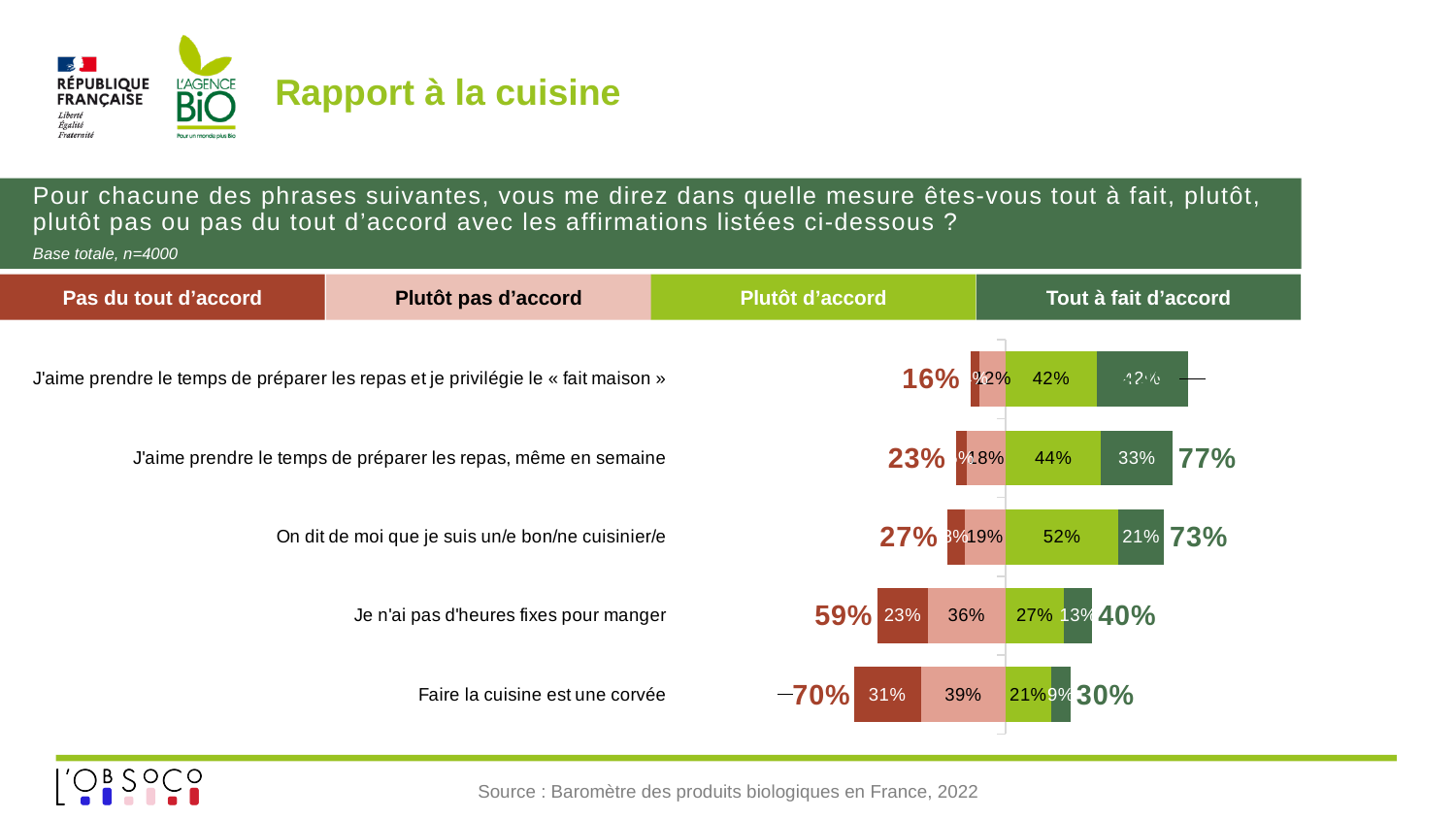
For "Faire la cuisine est une corvée", what is the difference between the "Plutôt pas d'accord" and "Pas du tout d'accord" shares? 8 percentage points What percentage answered "Pas du tout d'accord" to "Faire la cuisine est une corvée"? 31% Which statement has the highest share of "Plutôt d'accord" responses? On dit de moi que je suis un/e bon/ne cuisinier/e What percentage answered "Plutôt pas d'accord" to "Je n'ai pas d'heures fixes pour manger"? 36% How many statements are shown in the chart? 5 Which statement has the larger "Plutôt d'accord" share: "J'aime prendre le temps de préparer les repas, même en semaine" or "Je n'ai pas d'heures fixes pour manger"? J'aime prendre le temps de préparer les repas, même en semaine What kind of chart is shown on the slide? Stacked bar chart Which statement has the lowest share of "Tout à fait d'accord" responses? Faire la cuisine est une corvée How many response categories does the legend list? 4 What percentage answered "Plutôt d'accord" to "On dit de moi que je suis un/e bon/ne cuisinier/e"? 52% What is the combined share of "Plutôt d'accord" and "Tout à fait d'accord" for "Faire la cuisine est une corvée"? 30% What percentage answered "Tout à fait d'accord" to "J'aime prendre le temps de préparer les repas, même en semaine"? 33%